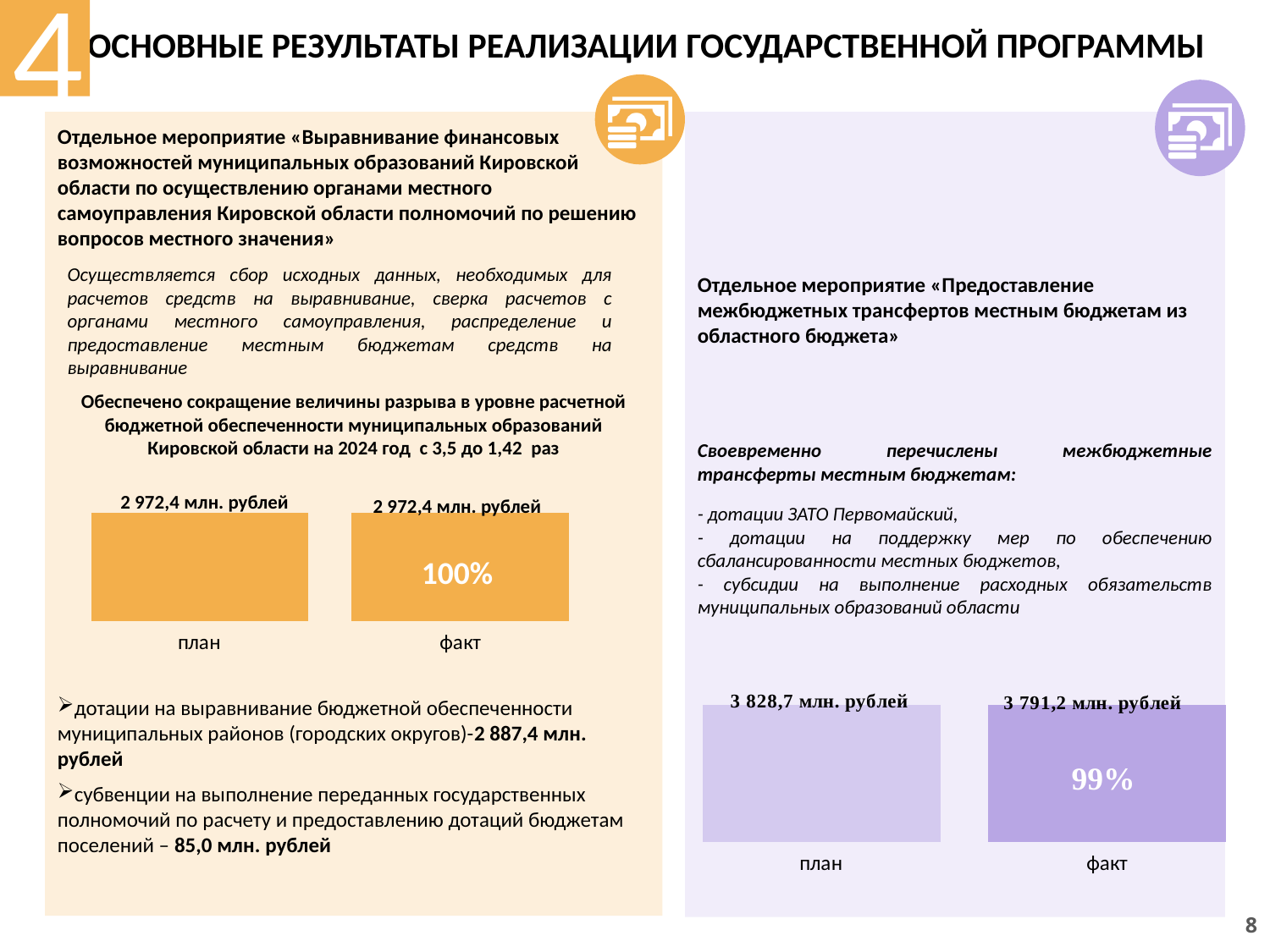
On the left (orange) chart, what is the value for факт? 2 972,4 млн. рублей On the right (purple) chart, what is the difference between план and факт? 37,5 млн. рублей What kind of chart is the right (purple) chart? bar chart On the left (orange) chart, what percentage is printed on the факт bar? 100% How many categories are shown on the left (orange) chart? 2 On the right (purple) chart, what percentage is printed on the факт bar? 99% What colour are the bars on the left chart? orange On the right (purple) chart, what is the value for план? 3 828,7 млн. рублей On the left (orange) chart, what is the value for план? 2 972,4 млн. рублей On the right (purple) chart, what is the value for факт? 3 791,2 млн. рублей On the right (purple) chart, which category has the higher value, план or факт? план On the left (orange) chart, what is the difference between план and факт? 0